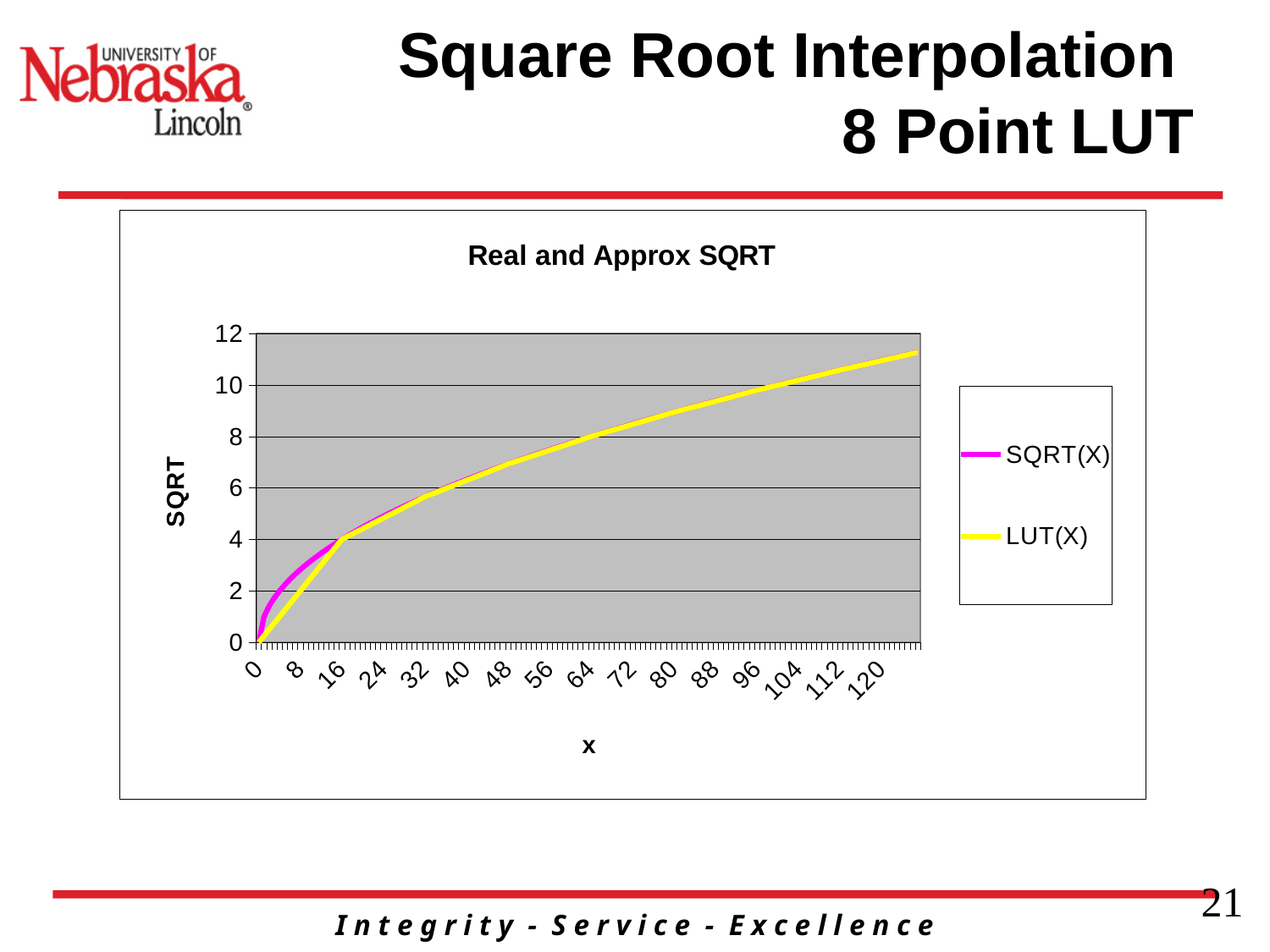
How many series does the legend list? 2 At x = 8, which series has the larger value, SQRT(X) or LUT(X)? SQRT(X) Is the value of SQRT(X) at x = 120 greater or less than 10? greater Is the value of LUT(X) at x = 48 greater or less than 6? greater Is the value of LUT(X) at x = 80 greater or less than 8? greater What is the highest value shown on the SQRT axis? 12 What is the value of SQRT(X) at x = 16? 4 Do the values of SQRT(X) rise or fall as x increases? rise What is the title of the chart? Real and Approx SQRT What kind of chart is shown on the slide? line chart Which series is drawn in yellow? LUT(X)